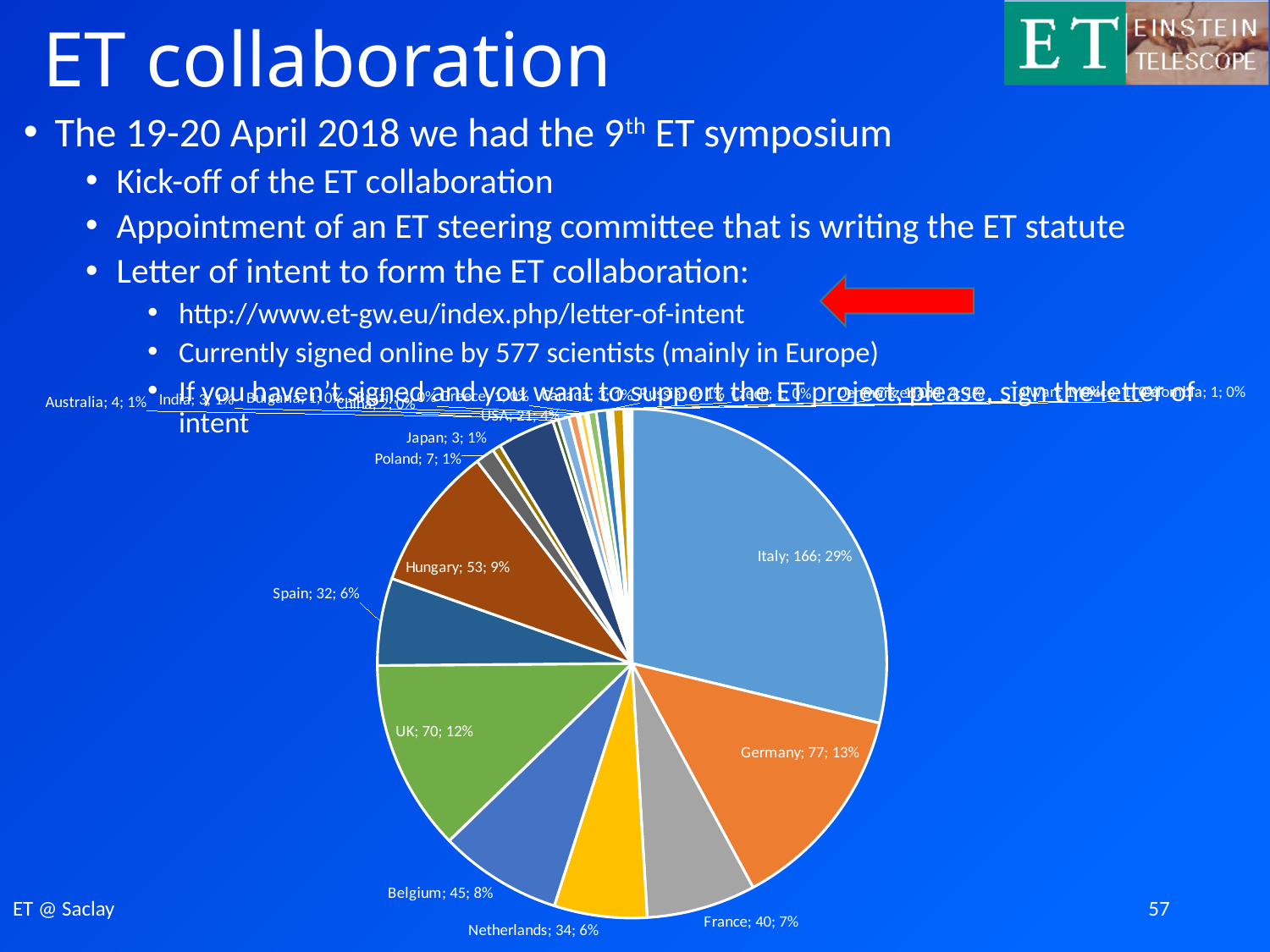
What share of the pie does Spain represent? 6% What is the value shown for the UK in the pie chart? 70 What is the difference between the values for the UK and Belgium? 25 What is the difference between the values for Italy and Germany? 89 What is the value shown for Poland in the pie chart? 7 Which country has the largest slice of the pie chart? Italy What is the value shown for the Netherlands in the pie chart? 34 What share of the pie does Germany represent? 13% Which is larger in the pie chart, the value for Belgium or the value for France? Belgium What kind of chart is shown on the slide? pie chart What percentage is shown for Hungary in the pie chart? 9% How many signatories does the pie chart show for Italy? 166